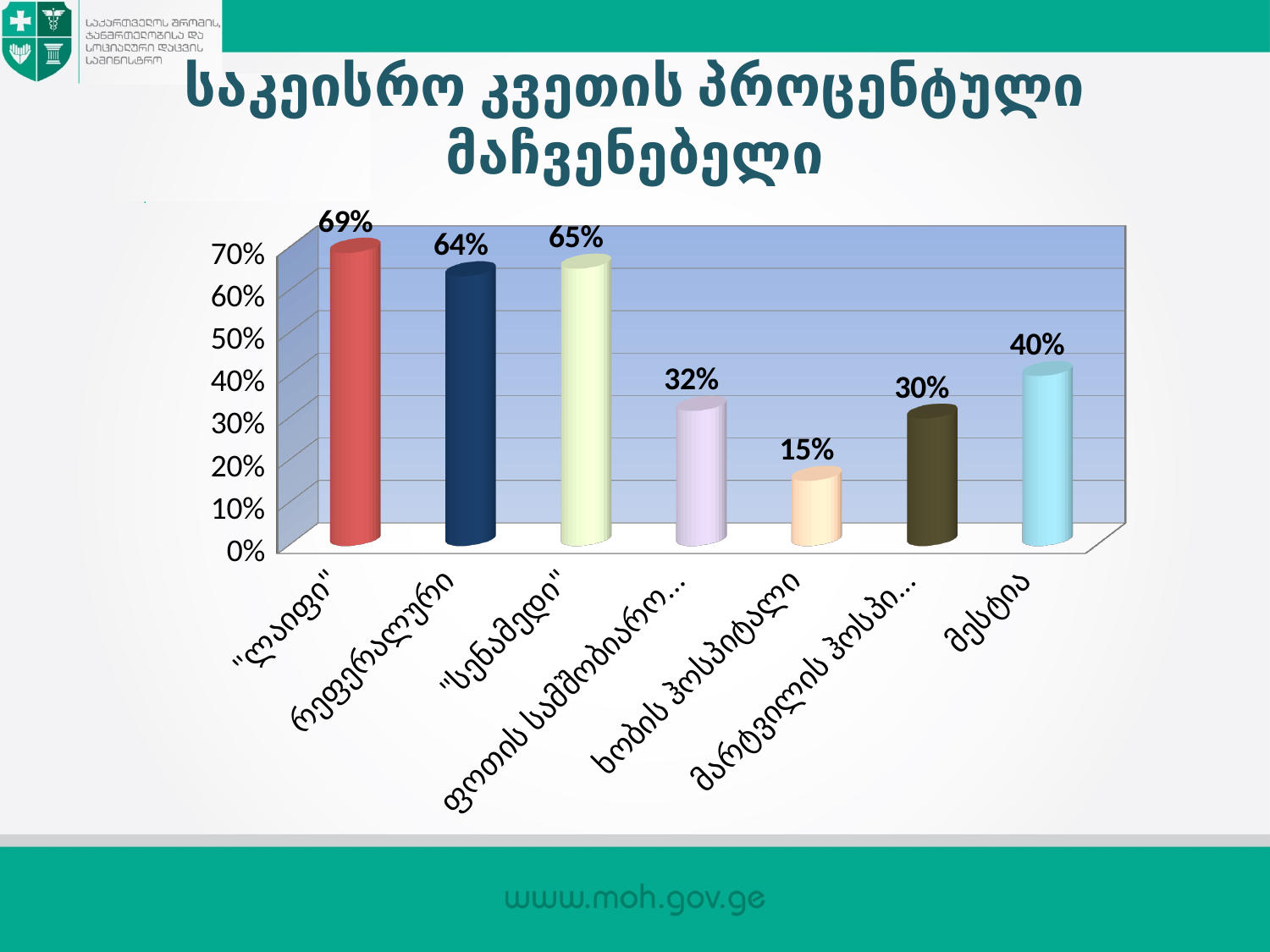
What is the value for მესტია? 40% What is the value for "სენამედი"? 65% Which is larger, the value for "სენამედი" or the value for რეფერალური? "სენამედი" What is the title of the chart on the slide? საკვეისრო კვეთის პროცენტული მაჩვენებელი What is the value for ხობის ჰოსპიტალი? 15% How many categories are shown in the chart? 7 What is the value for "ლაიფი"? 69% Which category has the highest value? "ლაიფი" Which category has the lowest value? ხობის ჰოსპიტალი What is the value for რეფერალური? 64% What kind of chart is shown on the slide? Bar chart What is the difference between the values for "ლაიფი" and მესტია? 29%